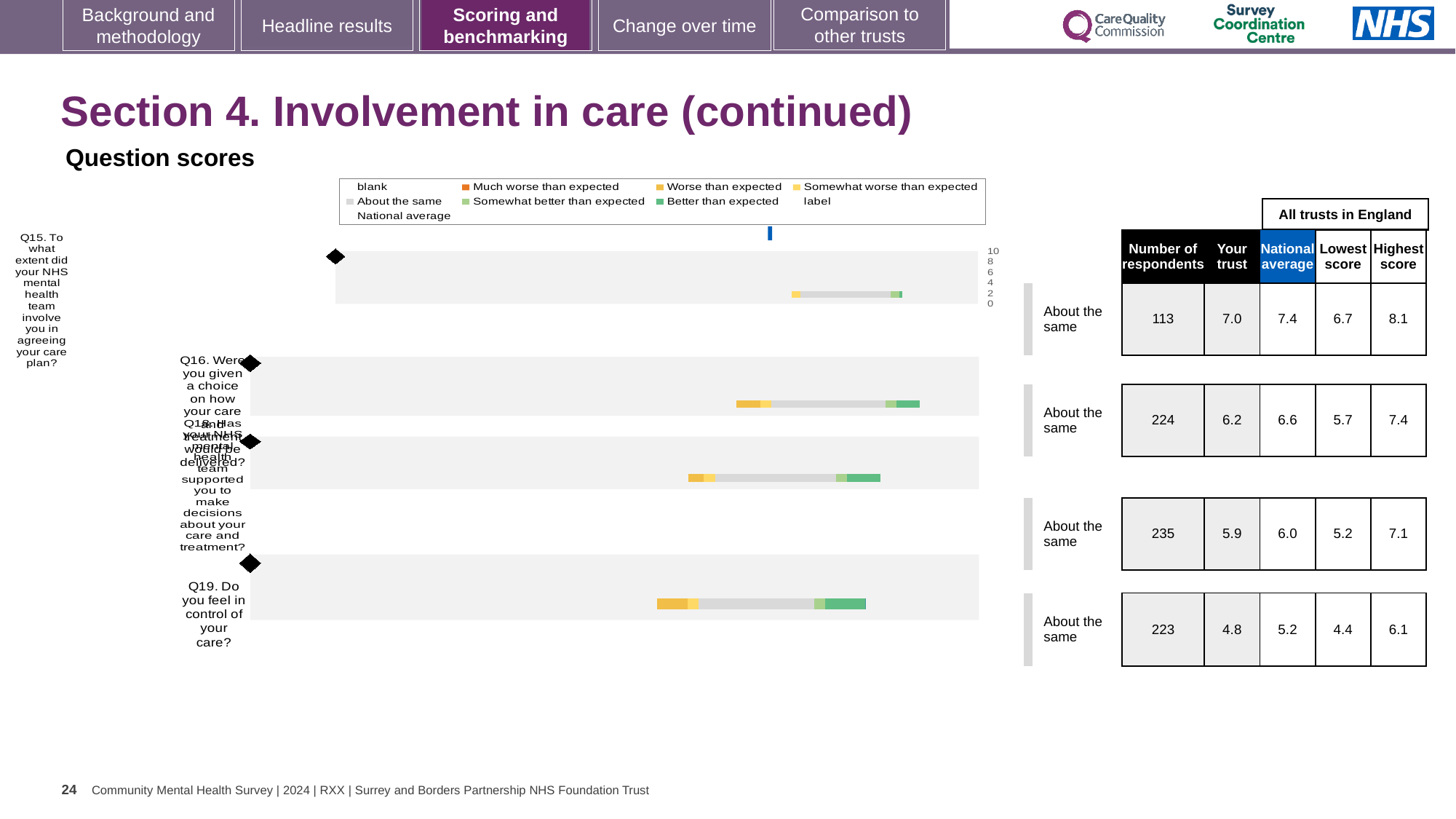
Which question has the lowest 'Your trust' score? Q19 How many questions (categories) are plotted in the question scores chart? 4 For Q18, which is larger: the 'Your trust' score or the national average? National average What is the national average score for Q19 (Do you feel in control of your care?)? 5.2 Which question has the highest 'Your trust' score? Q15 What is the lowest score among all trusts in England for Q18? 5.2 How many respondents answered Q16 (choice on how care and treatment would be delivered)? 224 What benchmark category is shown for Q19 next to the chart? About the same What is the 'Your trust' score for Q15 (involvement in agreeing your care plan)? 7.0 What kind of chart is used to show the question scores on this slide? Bar chart What is the difference between the highest score (8.1) and the lowest score (6.7) for Q15? 1.4 For Q16, how much higher is the national average (6.6) than the 'Your trust' score (6.2)? 0.4